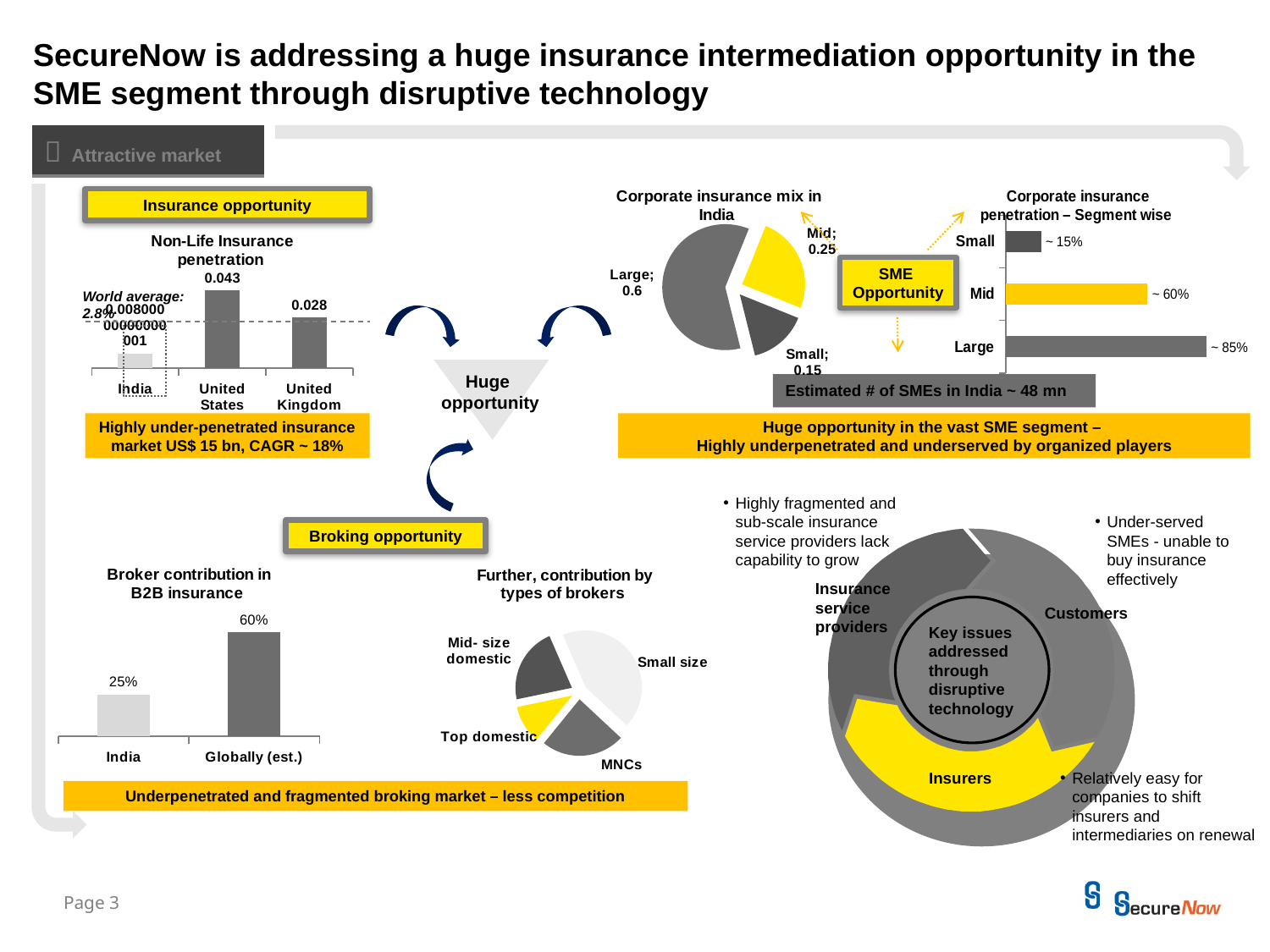
In the Non-Life Insurance penetration chart, which country has the highest value? United States In the Corporate insurance mix in India pie chart, how many segments are shown? 3 In the Corporate insurance mix in India pie chart, what share does the Small segment have? 0.15 In the Non-Life Insurance penetration chart, what is the difference between the United States and United Kingdom values? 0.015 In the Corporate insurance penetration – Segment wise chart, which segment has the highest penetration? Large In the Broker contribution in B2B insurance chart, what is the value for India? 25% In the Corporate insurance penetration – Segment wise chart, which is larger, Small or Mid? Mid In the Non-Life Insurance penetration chart, what is the value for the United States? 0.043 In the Non-Life Insurance penetration chart, which country has the lowest value? India In the Broker contribution in B2B insurance chart, what is the difference between Globally (est.) and India? 35% In the Corporate insurance mix in India pie chart, what share does the Large segment have? 0.6 In the Non-Life Insurance penetration chart, what is the value for the United Kingdom? 0.028